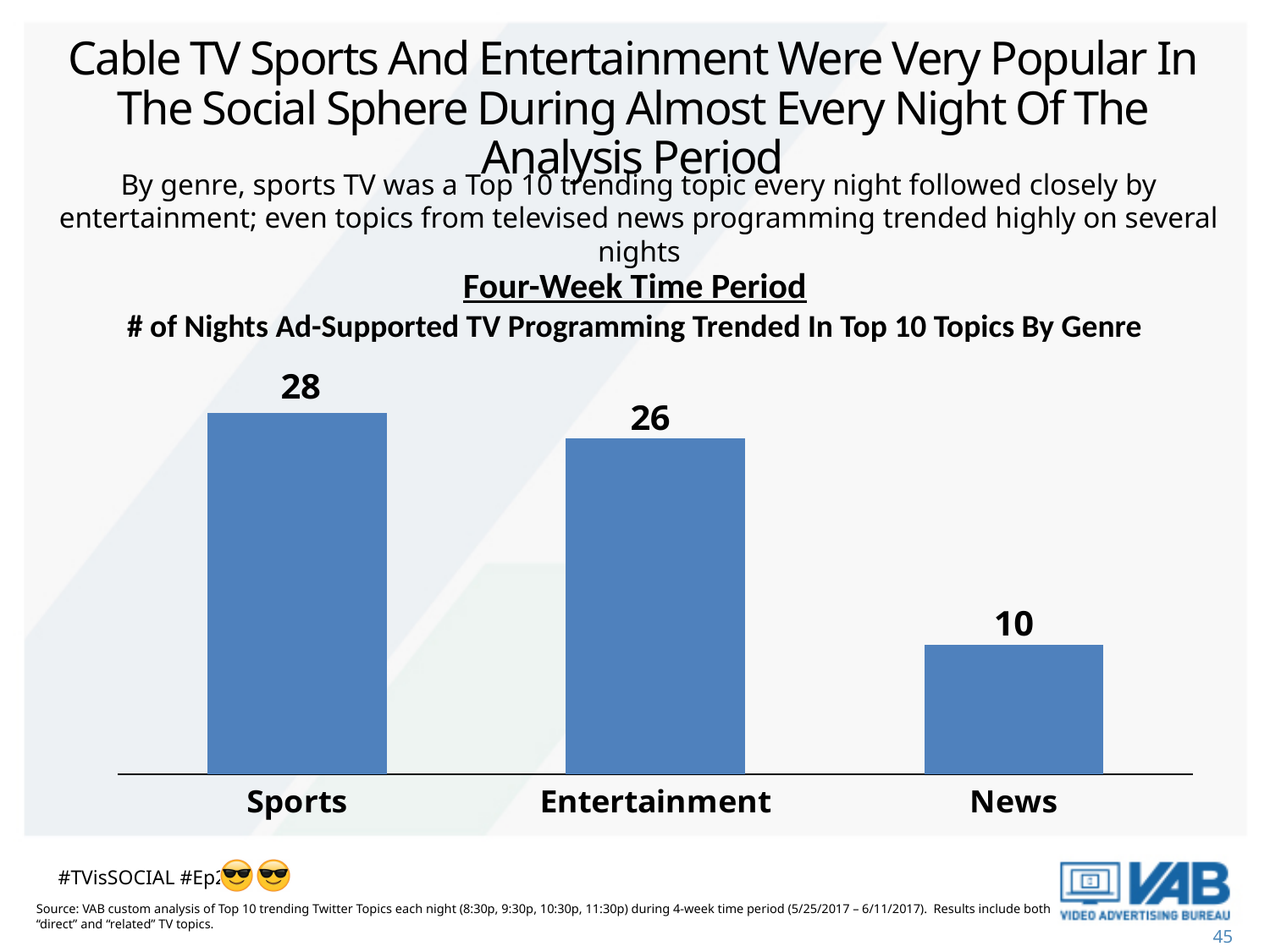
What is the difference in number of nights between Sports and Entertainment? 2 How many nights did News programming trend in the Top 10 topics? 10 Which genre trended in the Top 10 topics on the fewest nights? News Do the values rise or fall moving from Sports to News along the x axis? Fall Which genre trended in the Top 10 topics on the most nights? Sports How many genres are shown in the chart? 3 How many nights did Entertainment programming trend in the Top 10 topics? 26 What time period does the chart cover, according to its heading? Four-Week Time Period What is the difference in number of nights between Sports and News? 18 What type of chart is used on this slide? Bar chart How many nights did Sports programming trend in the Top 10 topics? 28 Which genre trended on more nights, Entertainment or News? Entertainment